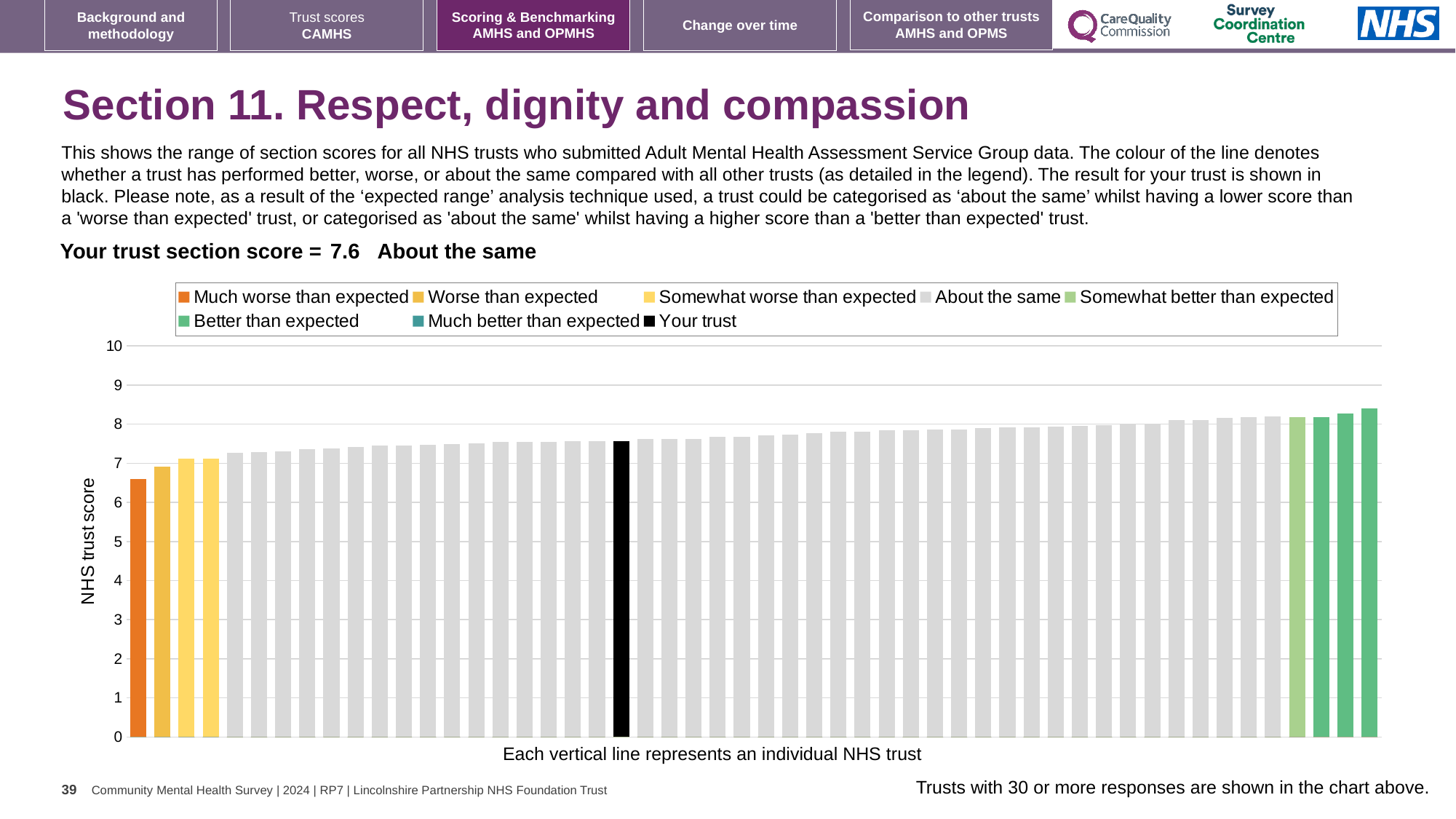
What is the label on the vertical axis of the chart? NHS trust score How many bars are coloured as 'Much worse than expected'? 1 Which legend category does the lowest bar in the chart belong to? Much worse than expected Which legend category does the highest bar in the chart belong to? Better than expected What kind of chart is shown on the slide? bar chart Do the bar values rise or fall from left to right across the chart? rise Is the value of the 'Much worse than expected' bar greater or less than 7? less What is the section score for your trust shown on the slide? 7.6 How many entries does the chart legend list? 8 Which category does your trust's section score fall into according to the slide? About the same Is the value of the 'Your trust' bar greater or less than 7? greater Is the value of the tallest bar in the chart greater or less than 8? greater